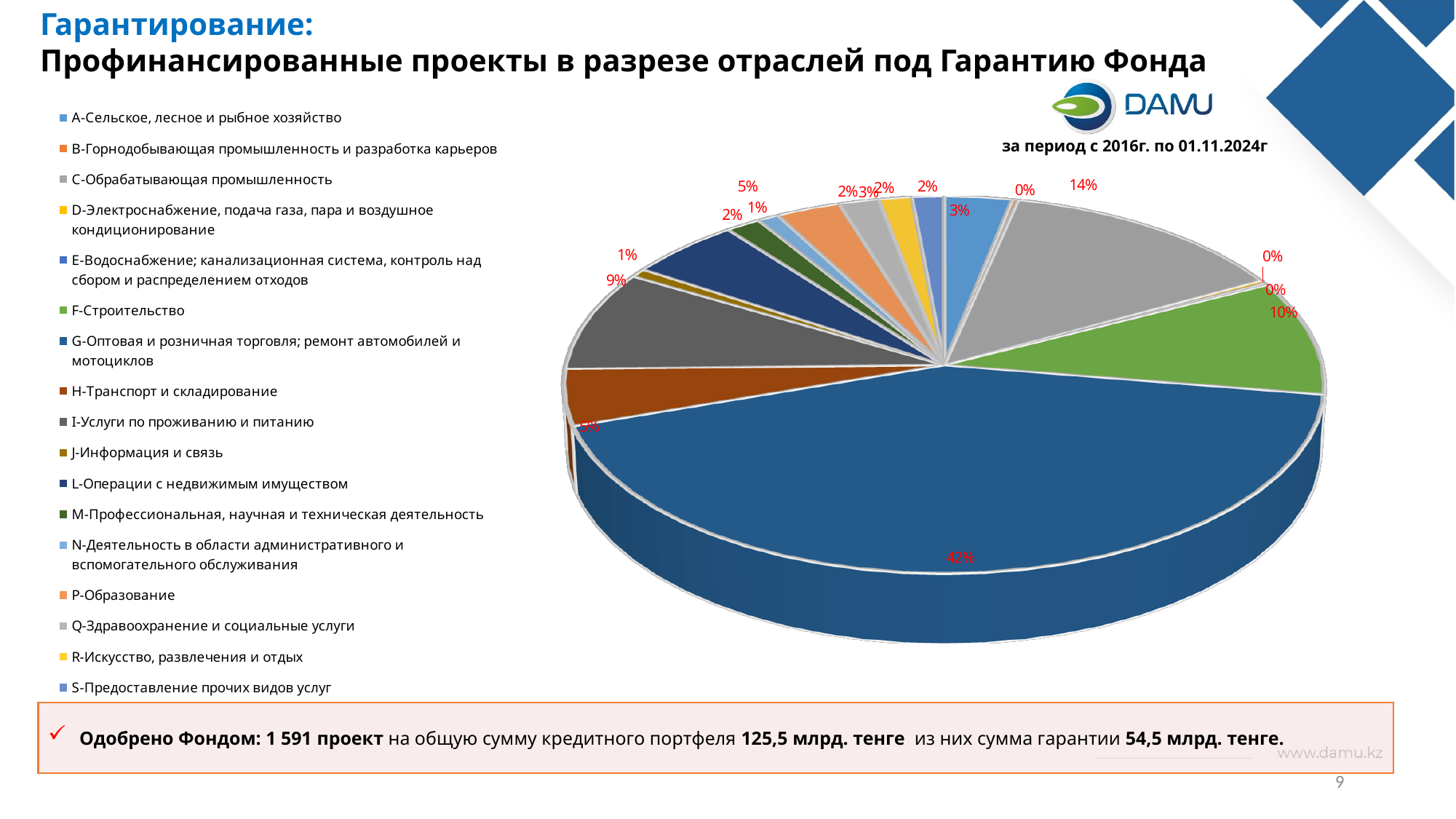
Which industry has the largest share of the pie? G-Оптовая и розничная торговля; ремонт автомобилей и мотоциклов What share of the pie does G-Оптовая и розничная торговля; ремонт автомобилей и мотоциклов have? 42% What share of the pie does F-Строительство have? 10% What kind of chart is shown on the slide? Pie chart What share of the pie does H-Транспорт и складирование have? 5% How many industry categories does the legend list? 17 Which has a larger share: C-Обрабатывающая промышленность or F-Строительство? C-Обрабатывающая промышленность What period does the chart cover, according to the text above it? за период с 2016г. по 01.11.2024г What is the difference in percentage points between the share of G-Оптовая и розничная торговля and C-Обрабатывающая промышленность? 28 percentage points